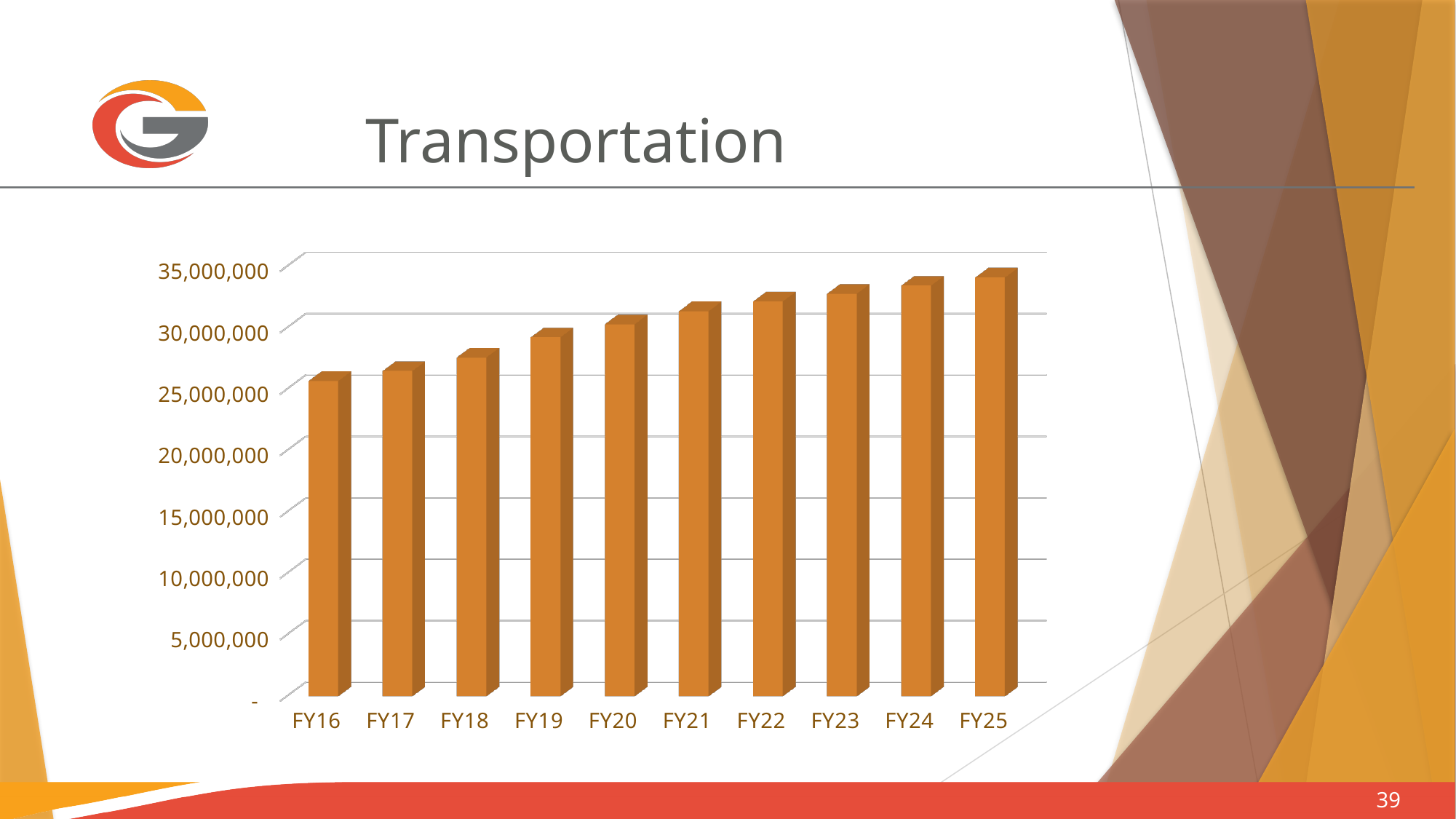
What kind of chart is shown on the slide? bar chart Is the value for FY25 greater or less than 30,000,000? greater Which fiscal year has the lowest bar? FY16 What is the title of the slide containing the chart? Transportation Which fiscal year has the highest bar? FY25 Is the value for FY18 greater or less than 25,000,000? greater Do the values rise or fall from FY16 to FY25? rise Is the value for FY22 greater or less than 35,000,000? less How many fiscal years are plotted on the x axis? 10 Which is larger, the value for FY20 or the value for FY17? FY20 What colour are the bars in the chart? orange